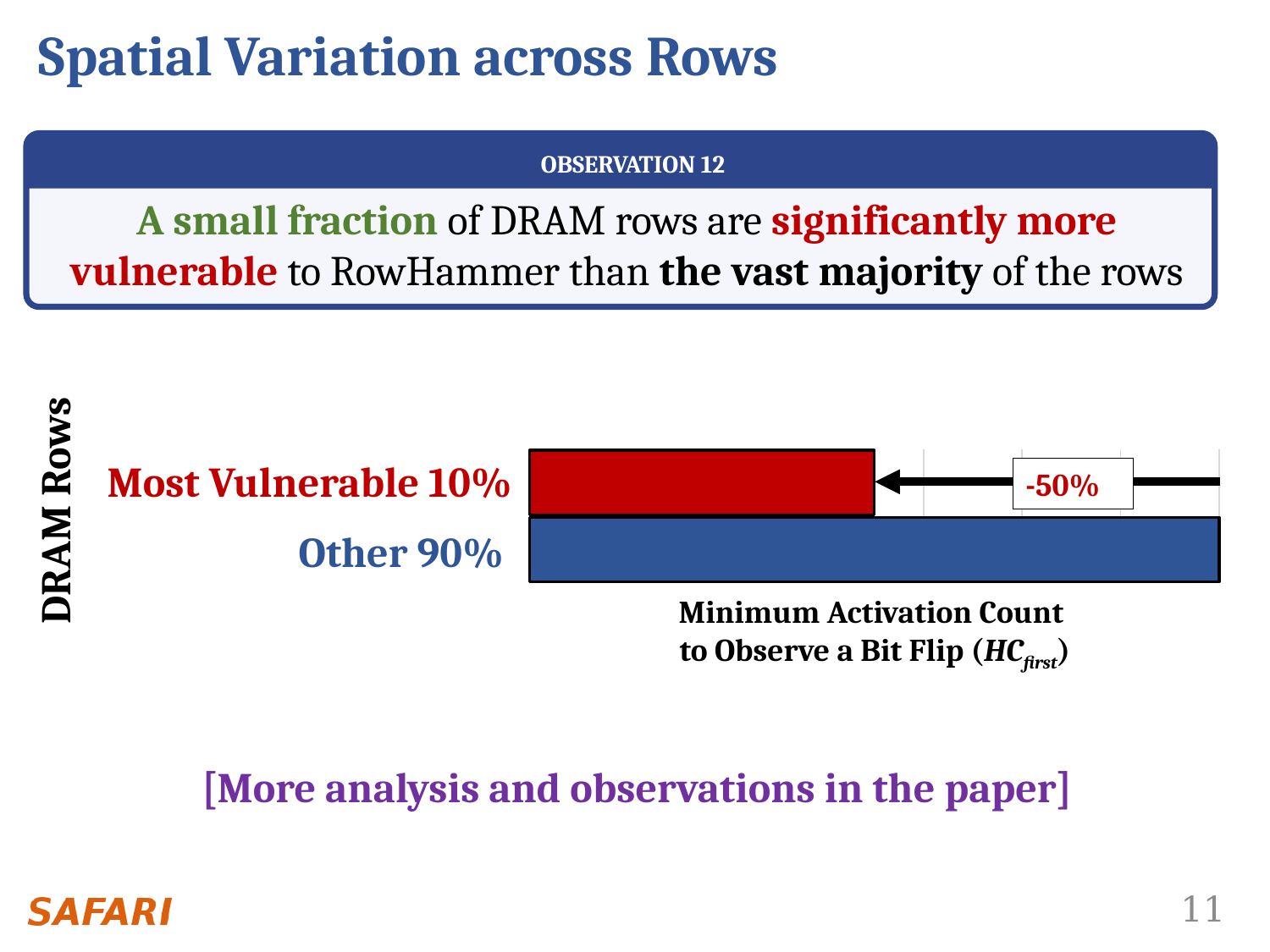
What is the label of the chart's x axis? Minimum Activation Count to Observe a Bit Flip (HCfirst) What kind of chart is shown on the slide? bar chart What percentage reduction is annotated on the chart for the Most Vulnerable 10% bar relative to the Other 90% bar? -50% What colour is the bar for Most Vulnerable 10%? red How many categories (bars) does the chart show? 2 Which category has the highest minimum activation count to observe a bit flip? Other 90% Which category has the lowest minimum activation count to observe a bit flip? Most Vulnerable 10% Which category has the longer bar, Most Vulnerable 10% or Other 90%? Other 90%